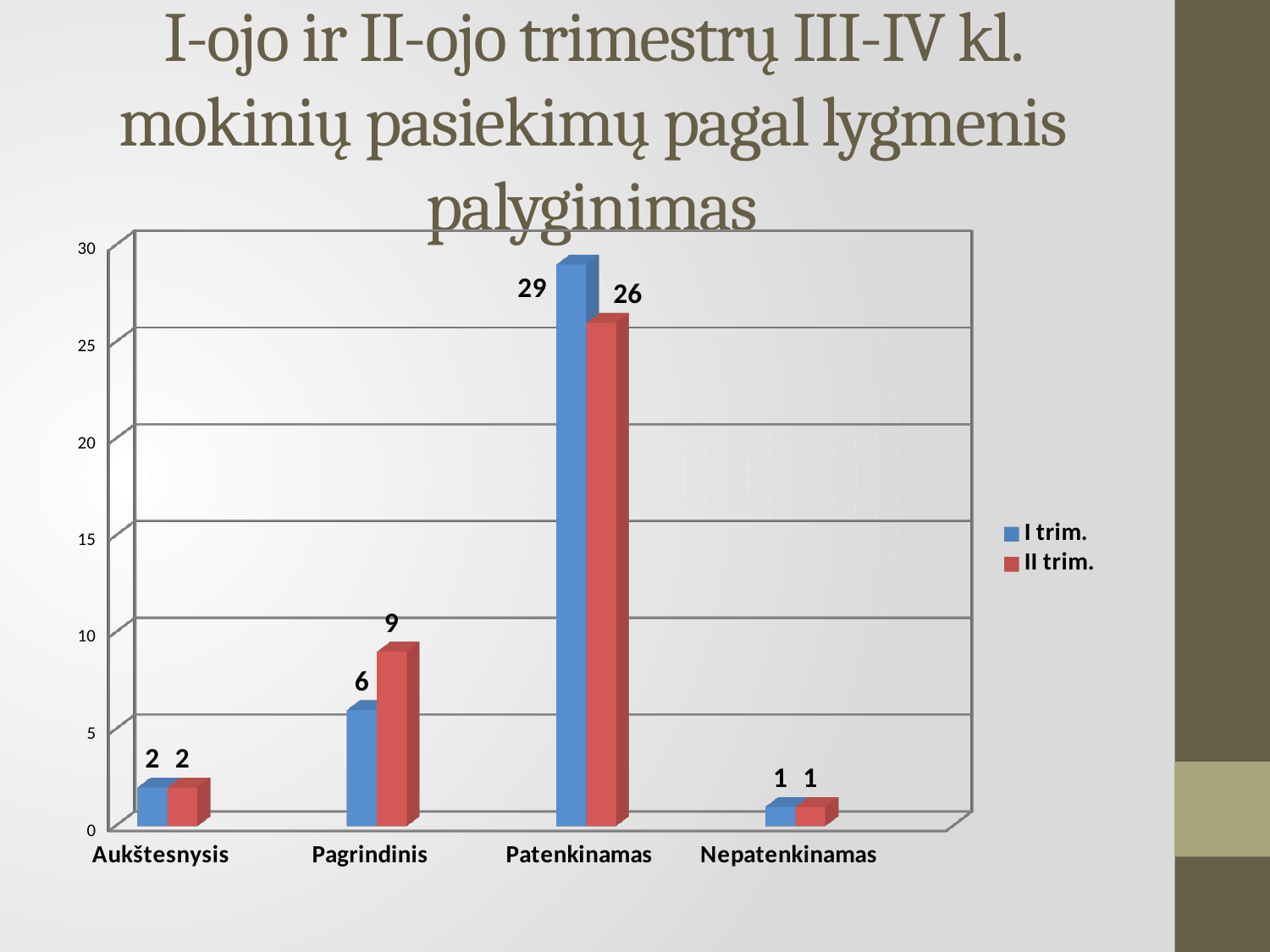
What is the value for Patenkinamas in the I trim. series? 29 Which is larger for Pagrindinis: the I trim. value or the II trim. value? II trim. Which category has the highest value in the II trim. series? Patenkinamas Which category has the lowest value in the I trim. series? Nepatenkinamas Which colour represents the II trim. series? Red How many categories are shown on the x axis? 4 What is the value for Aukštesnysis in the I trim. series? 2 Is the I trim. value for Patenkinamas greater or less than 25? greater What is the difference between the I trim. and II trim. values for Patenkinamas? 3 How many series does the legend list? 2 What kind of chart is shown on the slide? Bar chart What is the value for Pagrindinis in the II trim. series? 9